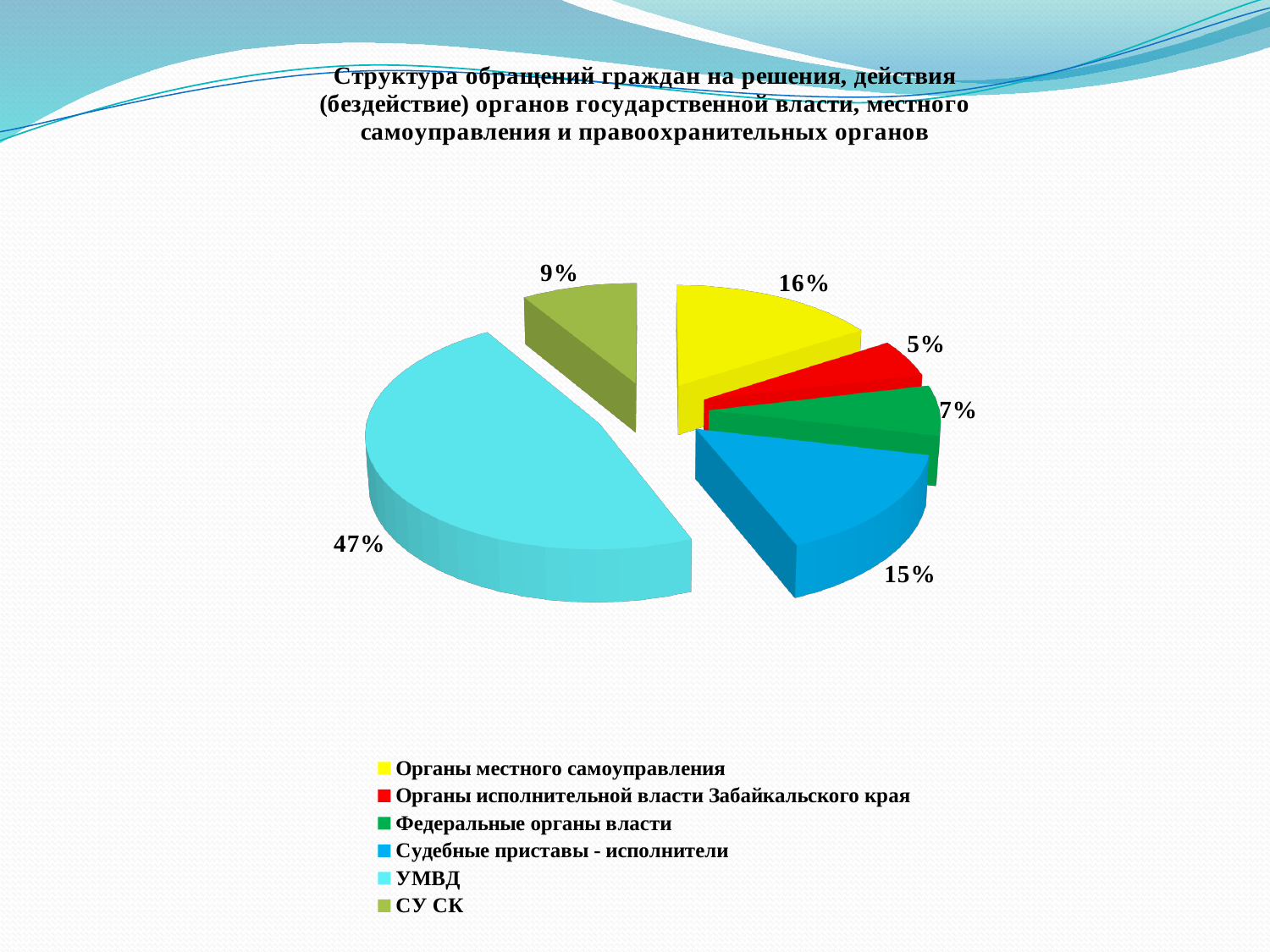
Which category has the largest share of the pie? УМВД What is the value for СУ СК? 9% What colour is the slice for Судебные приставы - исполнители? blue What is the value for Органы местного самоуправления? 16% How many categories does the legend list? 6 What is the value for Судебные приставы - исполнители? 15% Which category has the smallest share of the pie? Органы исполнительной власти Забайкальского края What share of the pie does УМВД account for? 47% Which is larger, the share for Федеральные органы власти or the share for СУ СК? СУ СК What is the difference between the shares of УМВД and Органы местного самоуправления? 31% What kind of chart is shown on the slide? pie chart What is the value for Федеральные органы власти? 7%